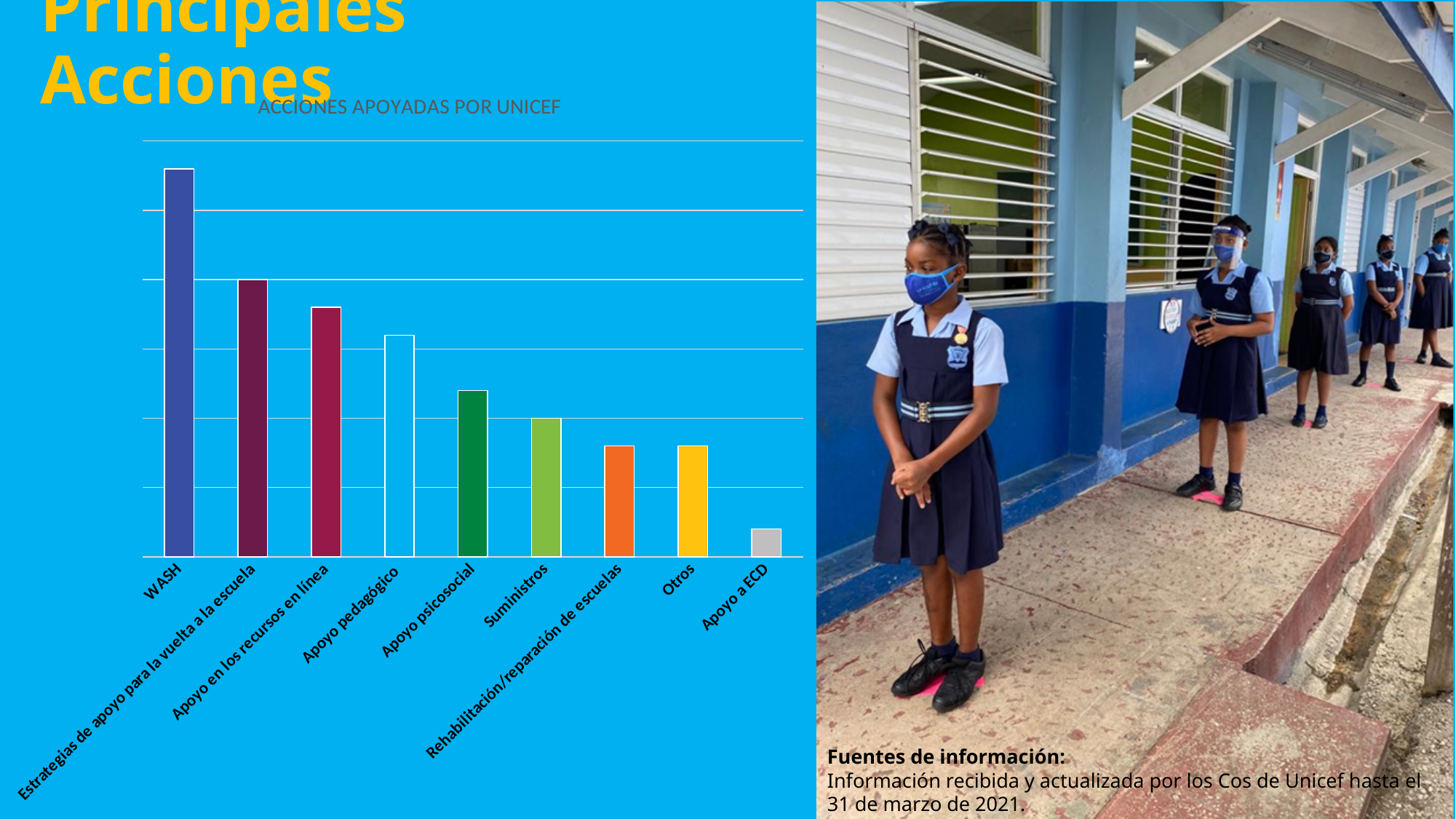
Which category has the highest bar in the chart? WASH Which category has the lowest bar in the chart? Apoyo a ECD What is the title of the chart? ACCIONES APOYADAS POR UNICEF Which category is shown second from the left on the x axis? Estrategias de apoyo para la vuelta a la escuela Do the bar values rise or fall from left to right along the x axis? Fall Which is larger, the value for Estrategias de apoyo para la vuelta a la escuela or the value for Apoyo pedagógico? Estrategias de apoyo para la vuelta a la escuela Which is larger, the value for Apoyo en los recursos en línea or the value for Otros? Apoyo en los recursos en línea What kind of chart is shown on the slide? Bar chart How many categories are shown on the x axis of the chart? 9 Which is larger, the value for WASH or the value for Apoyo a ECD? WASH